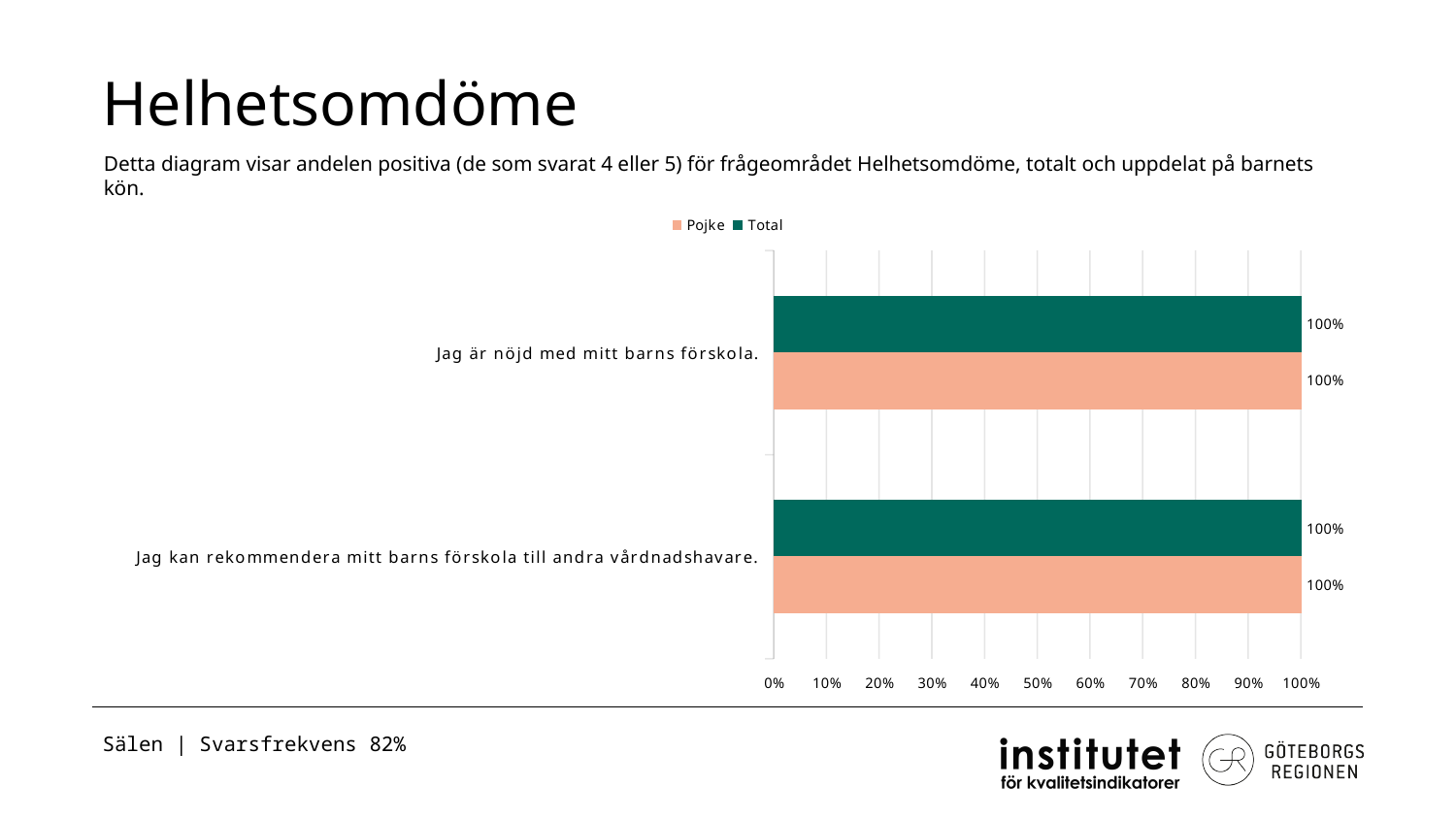
What is the difference between the Pojke and Total values for "Jag kan rekommendera mitt barns förskola till andra vårdnadshavare."? 0% What kind of chart is shown on the slide? Bar chart What is the value for Pojke for "Jag är nöjd med mitt barns förskola."? 100% What is the value for Total for "Jag kan rekommendera mitt barns förskola till andra vårdnadshavare."? 100% What is the highest value shown on the x axis? 100% What is the title of the slide containing the chart? Helhetsomdöme How many categories are shown on the chart? 2 How many series does the legend list? 2 Which series names are listed in the legend? Pojke and Total What is the value for Total for "Jag är nöjd med mitt barns förskola."? 100% What is the value for Pojke for "Jag kan rekommendera mitt barns förskola till andra vårdnadshavare."? 100% Is the value for Total for "Jag är nöjd med mitt barns förskola." greater or less than 50%? greater